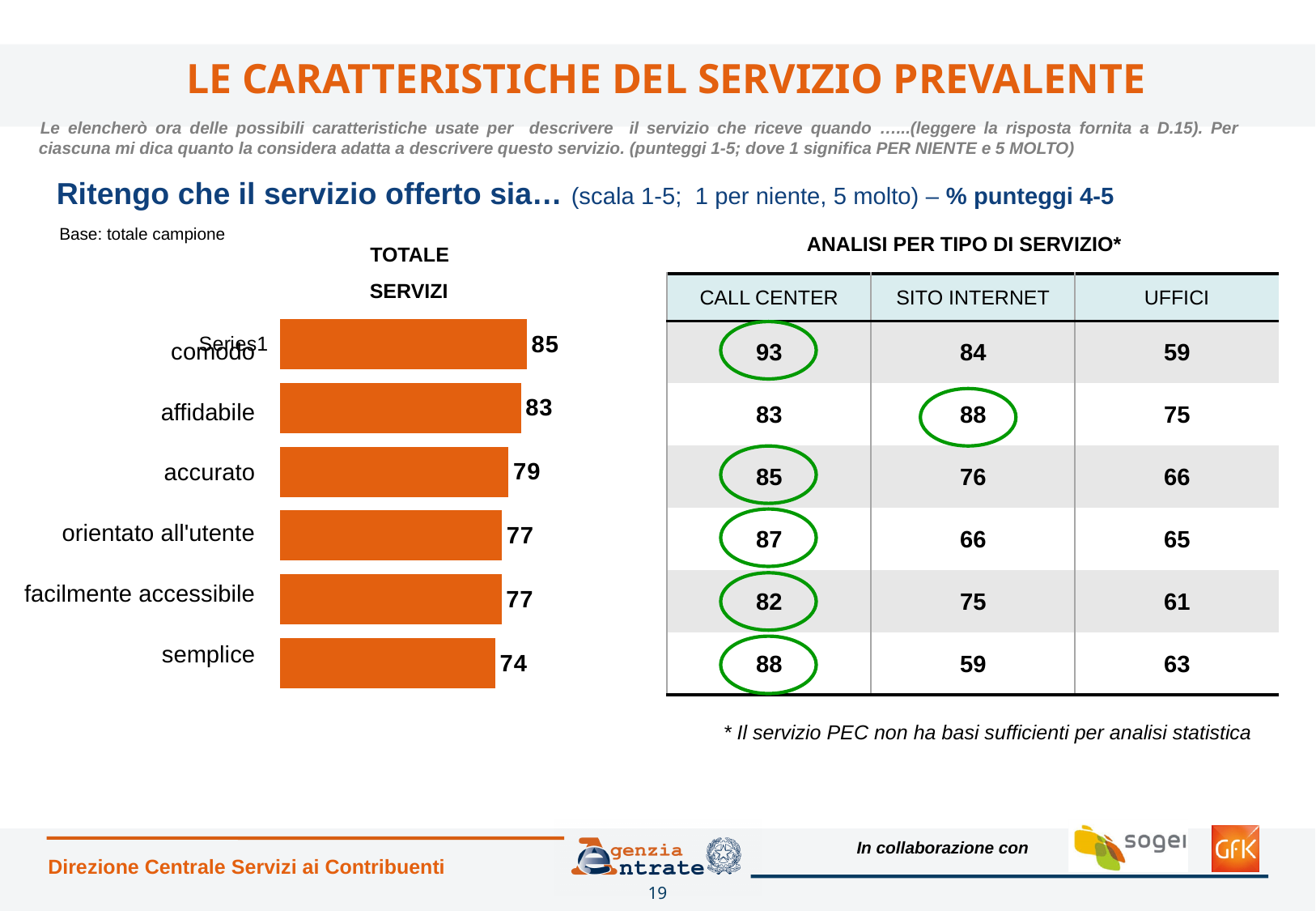
Which category has the highest value in the bar chart? comodo Which category has the lowest value in the bar chart? semplice How many categories are shown in the bar chart? 6 What is the value for "orientato all'utente" in the bar chart? 77 What is the difference between the values for "affidabile" and "accurato" in the bar chart? 4 What type of chart is shown on the slide? bar chart What is the title shown above the bar chart? TOTALE SERVIZI What is the value for "affidabile" in the bar chart? 83 Which is larger in the bar chart, the value for "accurato" or the value for "facilmente accessibile"? accurato What is the value for "semplice" in the bar chart? 74 What is the difference between the values for "comodo" and "semplice" in the bar chart? 11 What is the value for "accurato" in the bar chart? 79